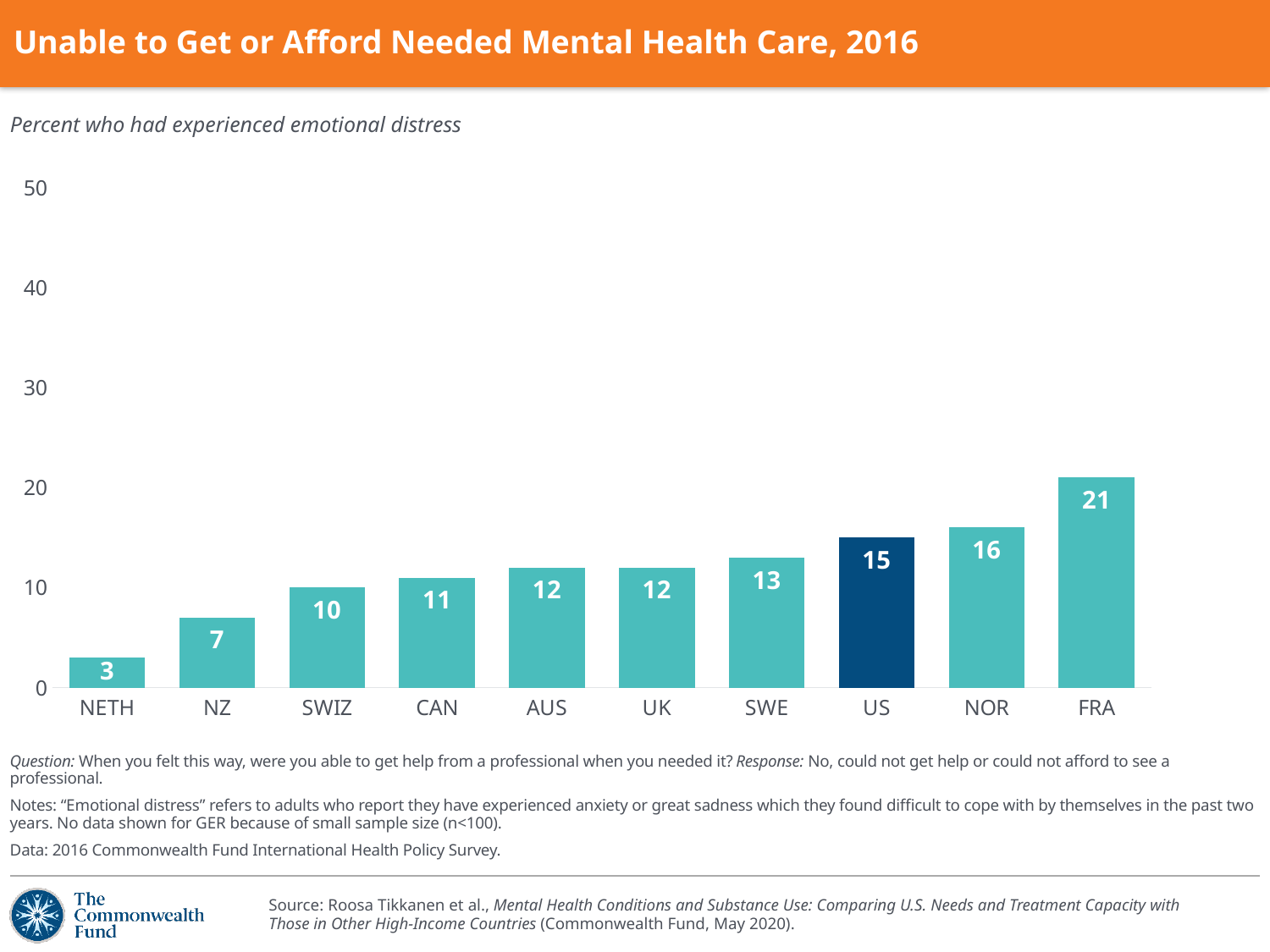
Which country has the highest value? FRA Which country has the lowest value? NETH What is the difference between the values for NOR and NZ? 9 Is the value for FRA greater or less than 20? greater How many countries are shown on the chart? 10 What is the value for the US? 15 Which bar is shown in a darker blue colour than the others? US What is the value for SWE? 13 What is the value for NETH? 3 Which is larger, the value for CAN or the value for SWIZ? CAN What kind of chart is shown on the slide? bar chart What is the difference between the values for FRA and the US? 6